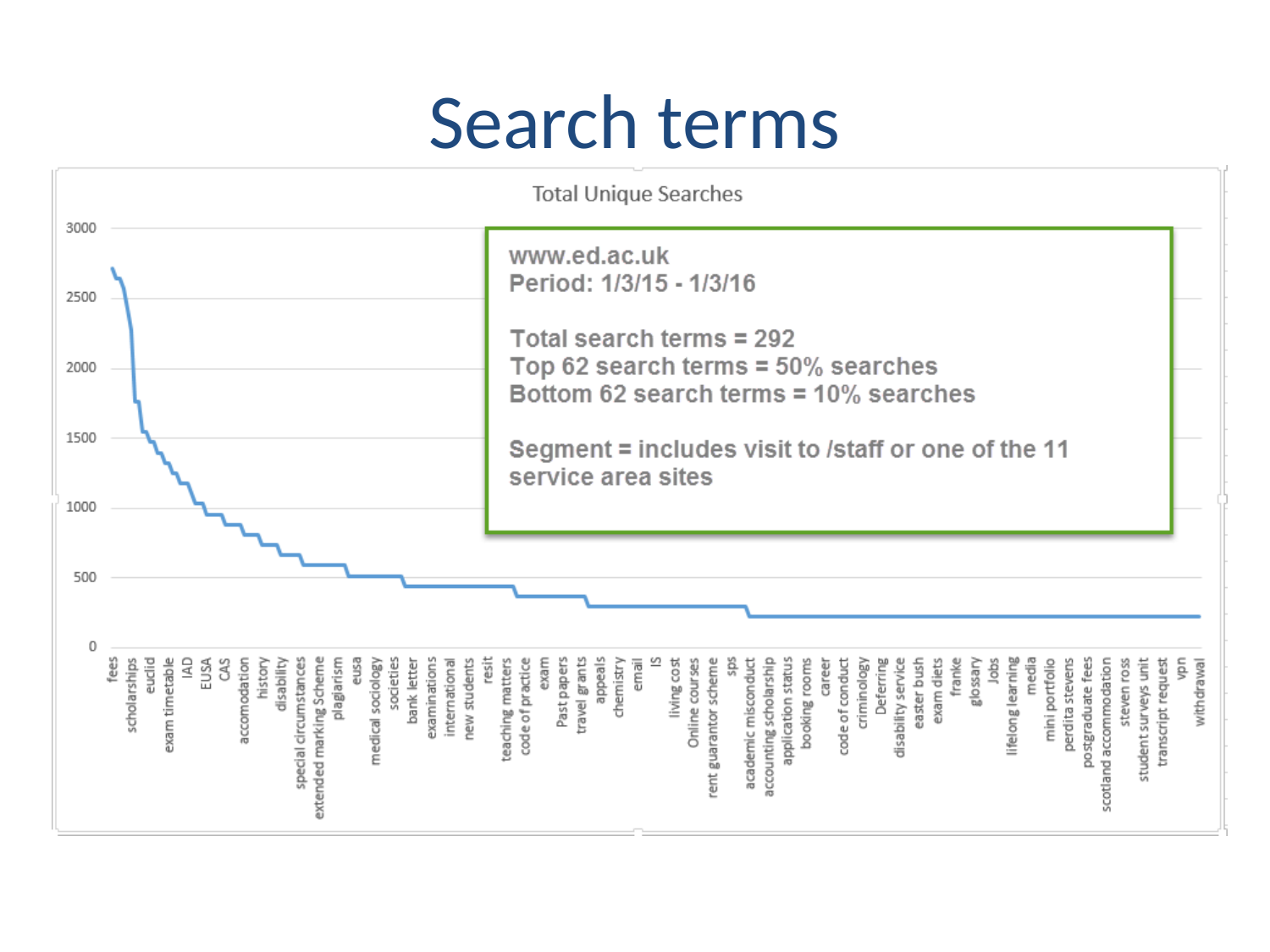
Which has more unique searches, fees or withdrawal? fees Which search term has the highest number of unique searches? fees What is the title of the chart? Total Unique Searches Is the value for plagiarism greater or less than 1000? less Is the value for withdrawal greater or less than 500? less Is the value for email greater or less than 500? less Do the values rise or fall moving left to right along the x axis? fall According to the text box on the chart, what is the total number of search terms? 292 What kind of chart is shown on the slide? line chart Which has more unique searches, history or vpn? history